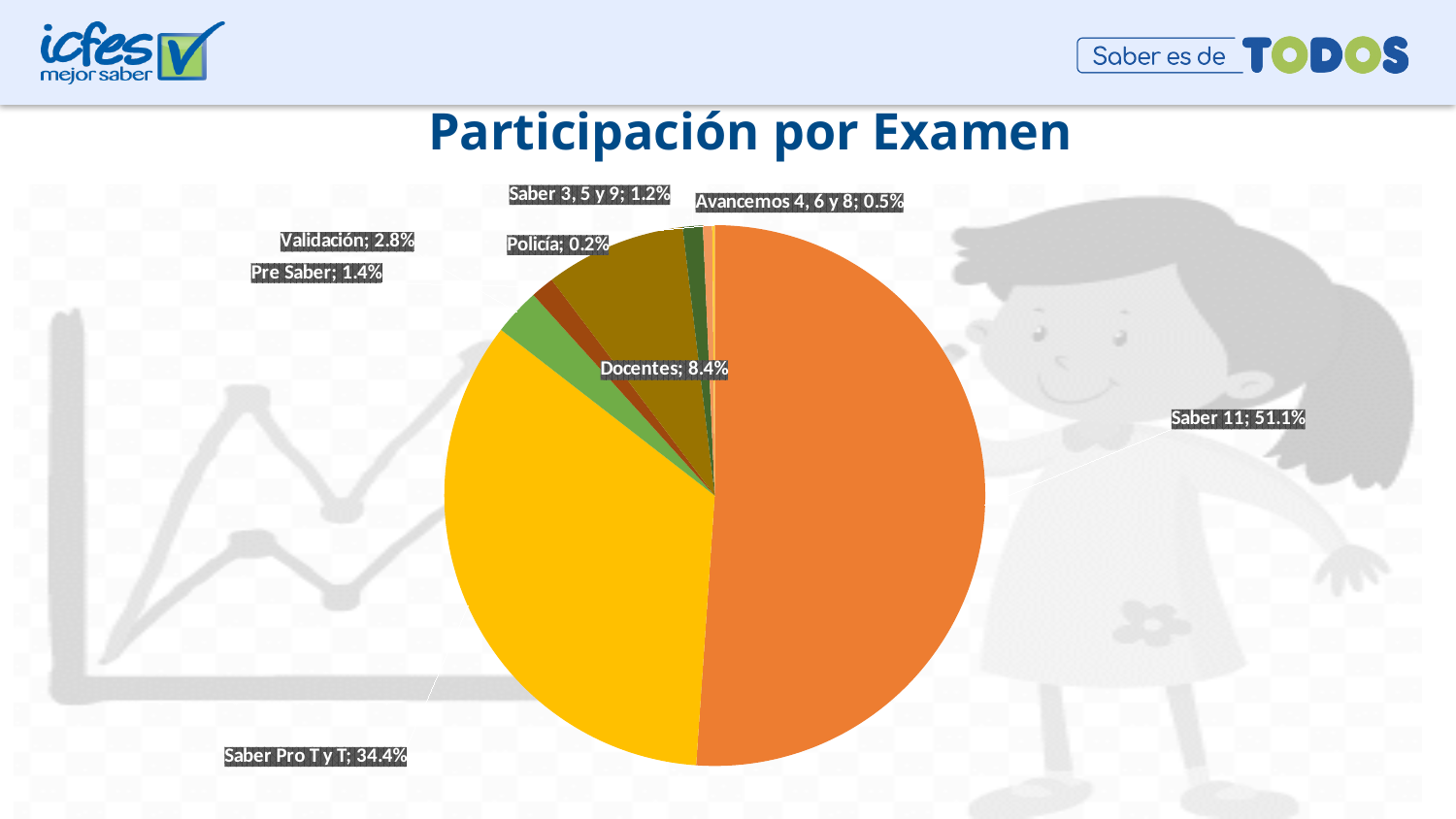
What is the value shown for Saber Pro T y T? 34.4% Which exam has the smallest share of the pie? Policía What is the title of the chart? Participación por Examen Which is larger, the share for Pre Saber or the share for Saber 3, 5 y 9? Pre Saber What is the difference between the shares of Saber 11 and Saber Pro T y T? 16.7% Which exam has the largest share of the pie? Saber 11 What share of the pie does Saber 11 have? 51.1% How many slices does the pie chart have? 8 What is the value shown for Docentes? 8.4% What is the value shown for Policía? 0.2% What is the value shown for Validación? 2.8% What kind of chart is shown on the slide? Pie chart